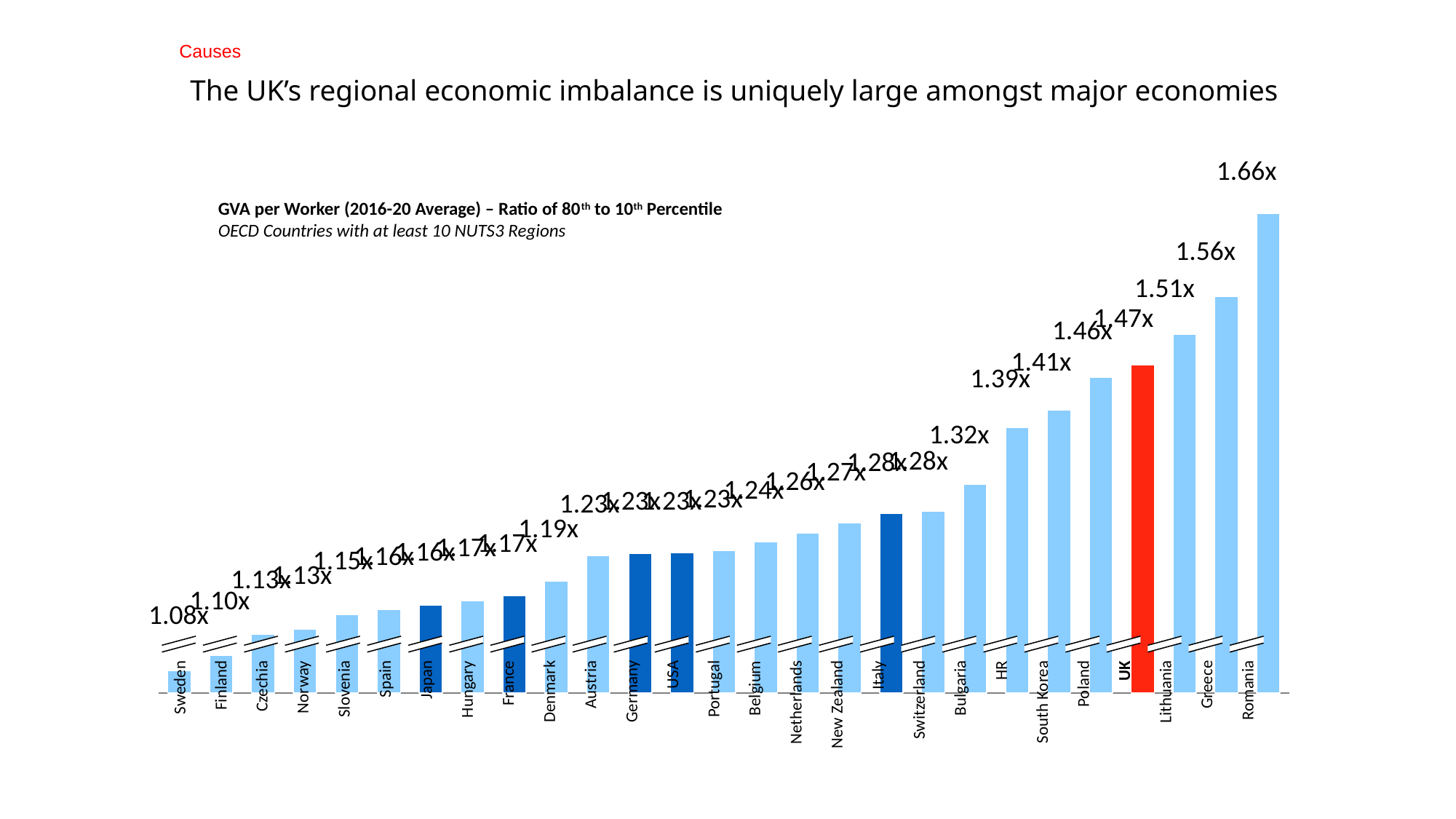
What is the GVA per worker ratio shown for Bulgaria? 1.32x Which country has the highest GVA per worker ratio of 80th to 10th percentile? Romania What kind of chart is shown on the slide? bar chart Which has a larger ratio, Greece or Lithuania? Greece What is the difference between Romania's ratio and the UK's ratio? 0.19x What is the GVA per worker ratio shown for Romania? 1.66x What colour is the bar for the UK? red What is the GVA per worker ratio shown for the UK? 1.47x How many countries are shown in the chart? 27 What is the GVA per worker ratio shown for Sweden? 1.08x Which country has the lowest GVA per worker ratio of 80th to 10th percentile? Sweden Do the values rise or fall moving from left to right along the x axis? rise